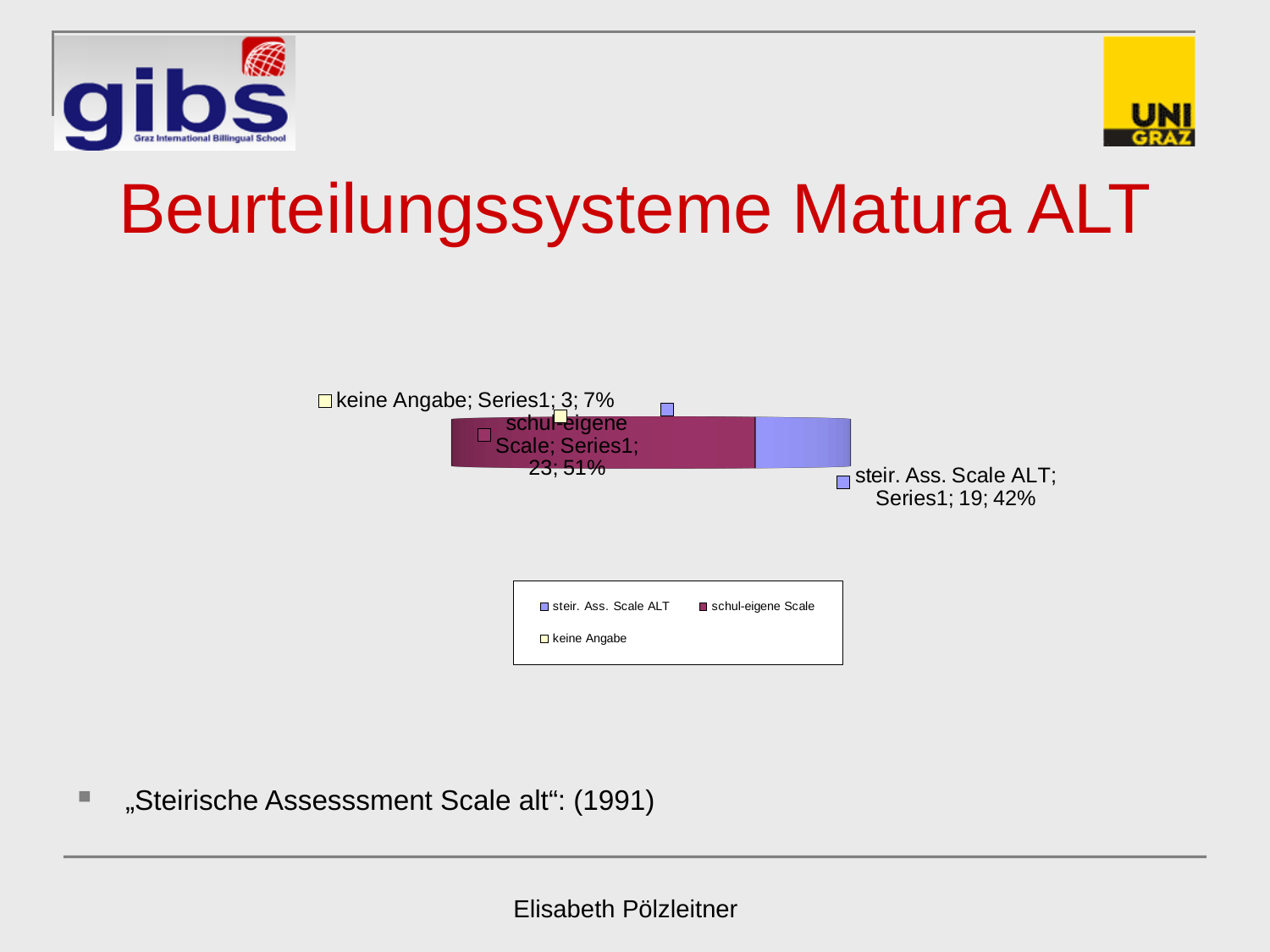
What is the difference between the values for "schul-eigene Scale" and "steir. Ass. Scale ALT"? 4 What value is shown for "steir. Ass. Scale ALT"? 19 How many slices does the pie chart have? 3 How many entries does the legend list? 3 What percentage share does "steir. Ass. Scale ALT" have? 42% Which category has the largest slice? schul-eigene Scale What kind of chart is shown on the slide? pie chart Which category has the smallest slice? keine Angabe What value is shown for "keine Angabe"? 3 What percentage share does "keine Angabe" have? 7% What percentage share does "schul-eigene Scale" have? 51% What value is shown for "schul-eigene Scale"? 23